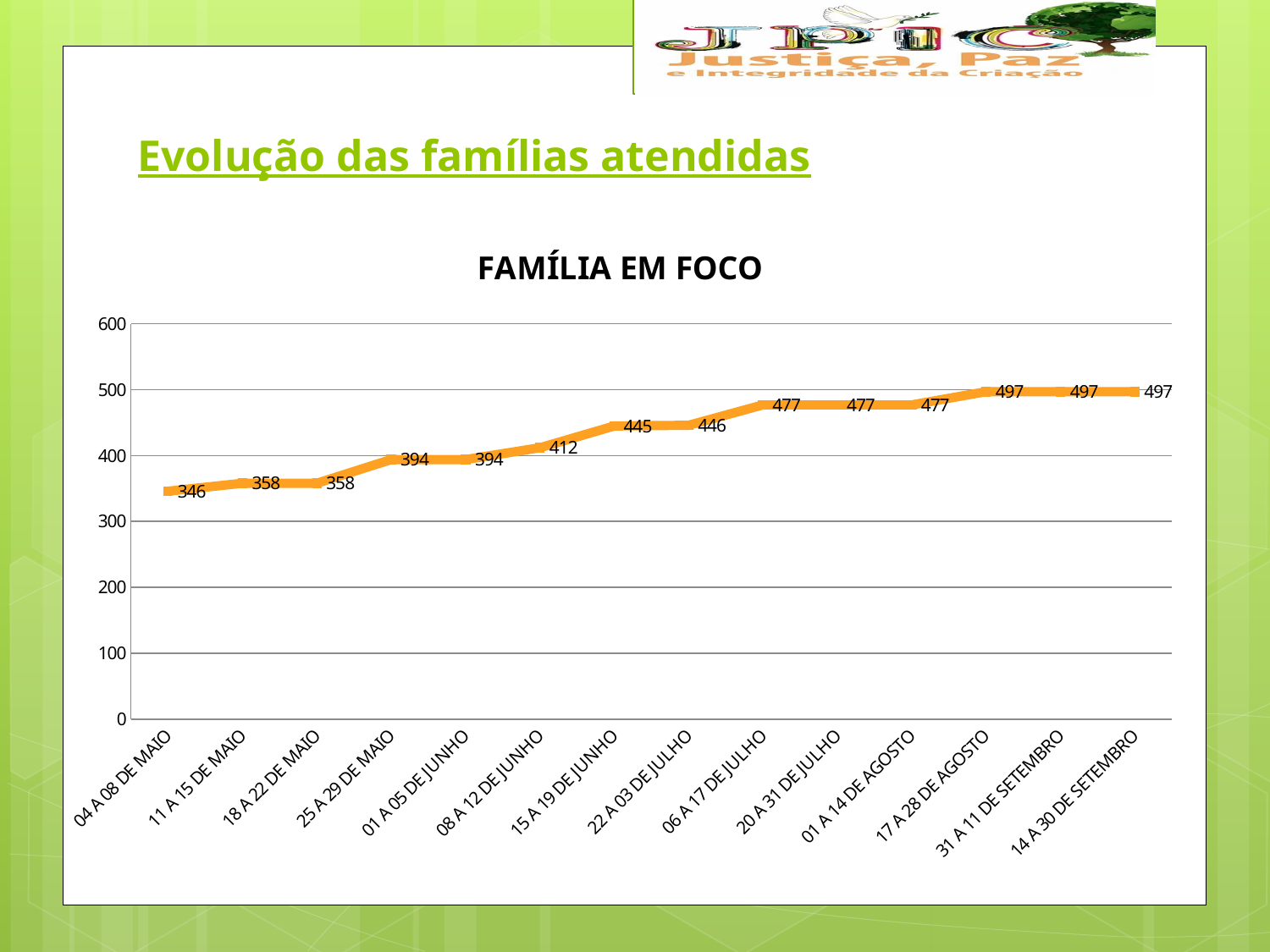
What is the highest value plotted on the chart? 497 How many periods are plotted on the x axis? 14 What is the value for 14 A 30 DE SETEMBRO? 497 What is the value for 04 A 08 DE MAIO? 346 What is the value for 08 A 12 DE JUNHO? 412 What type of chart is shown on the slide? line chart Do the values generally rise or fall from left to right along the x axis? rise What is the title of the chart? FAMÍLIA EM FOCO Which period has the lowest value? 04 A 08 DE MAIO What is the difference between the values for 14 A 30 DE SETEMBRO and 04 A 08 DE MAIO? 151 Which is larger, the value for 15 A 19 DE JUNHO or the value for 25 A 29 DE MAIO? 15 A 19 DE JUNHO What is the value for 22 A 03 DE JULHO? 446